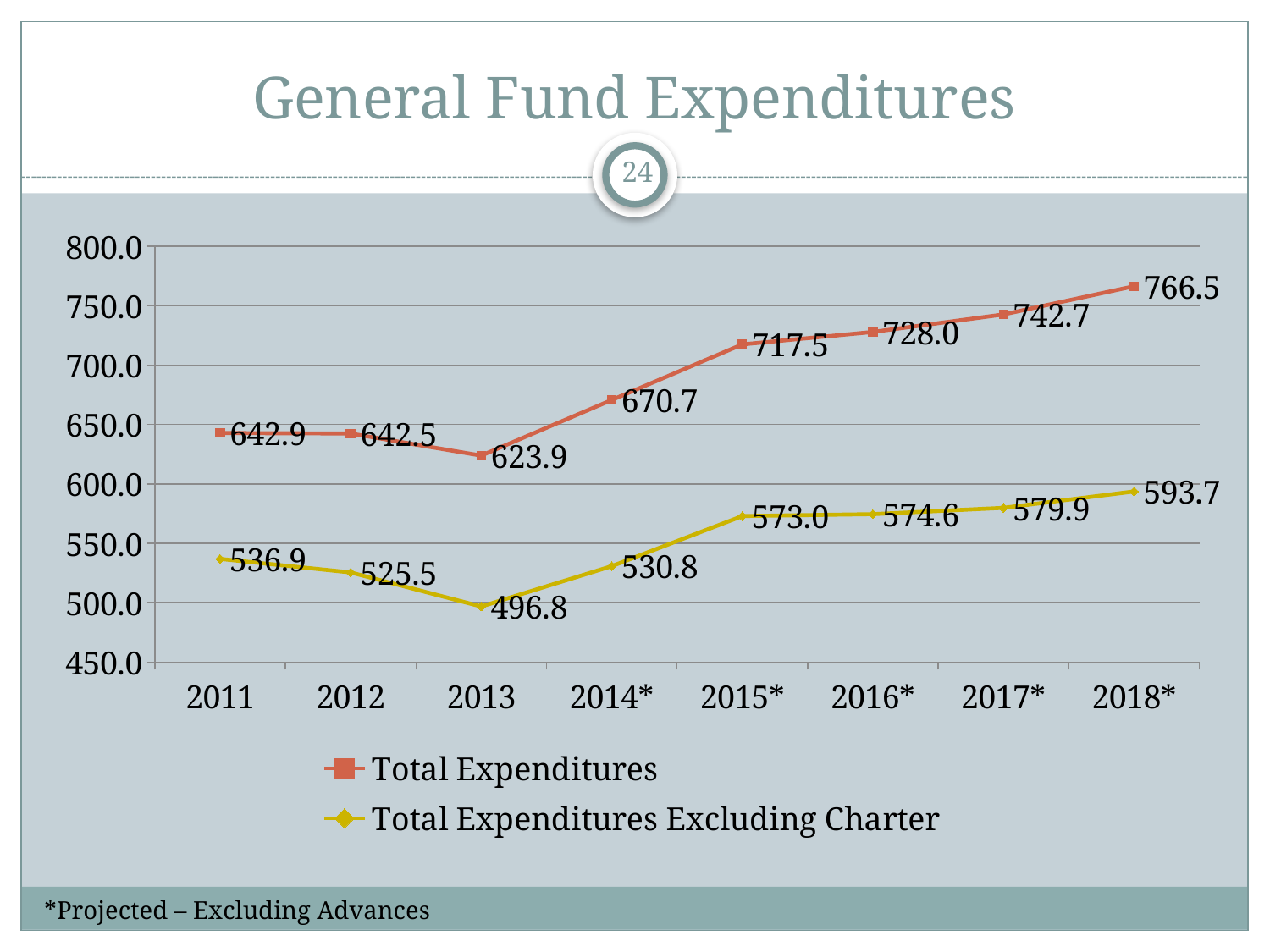
In which year is Total Expenditures Excluding Charter lowest? 2013 Does Total Expenditures rise or fall from 2013 to 2018*? Rise How many years are shown on the x axis? 8 What does the asterisk on the years indicate, according to the footnote? Projected – Excluding Advances What is the difference between Total Expenditures and Total Expenditures Excluding Charter in 2018*? 172.8 Which is larger: Total Expenditures in 2011 or Total Expenditures in 2012? Total Expenditures in 2011 What is the title of the chart? General Fund Expenditures What kind of chart is shown on the slide? Line chart What is the value of Total Expenditures Excluding Charter in 2016*? 574.6 How many series does the legend list? 2 What is the value of Total Expenditures in 2013? 623.9 In which year is Total Expenditures highest? 2018*